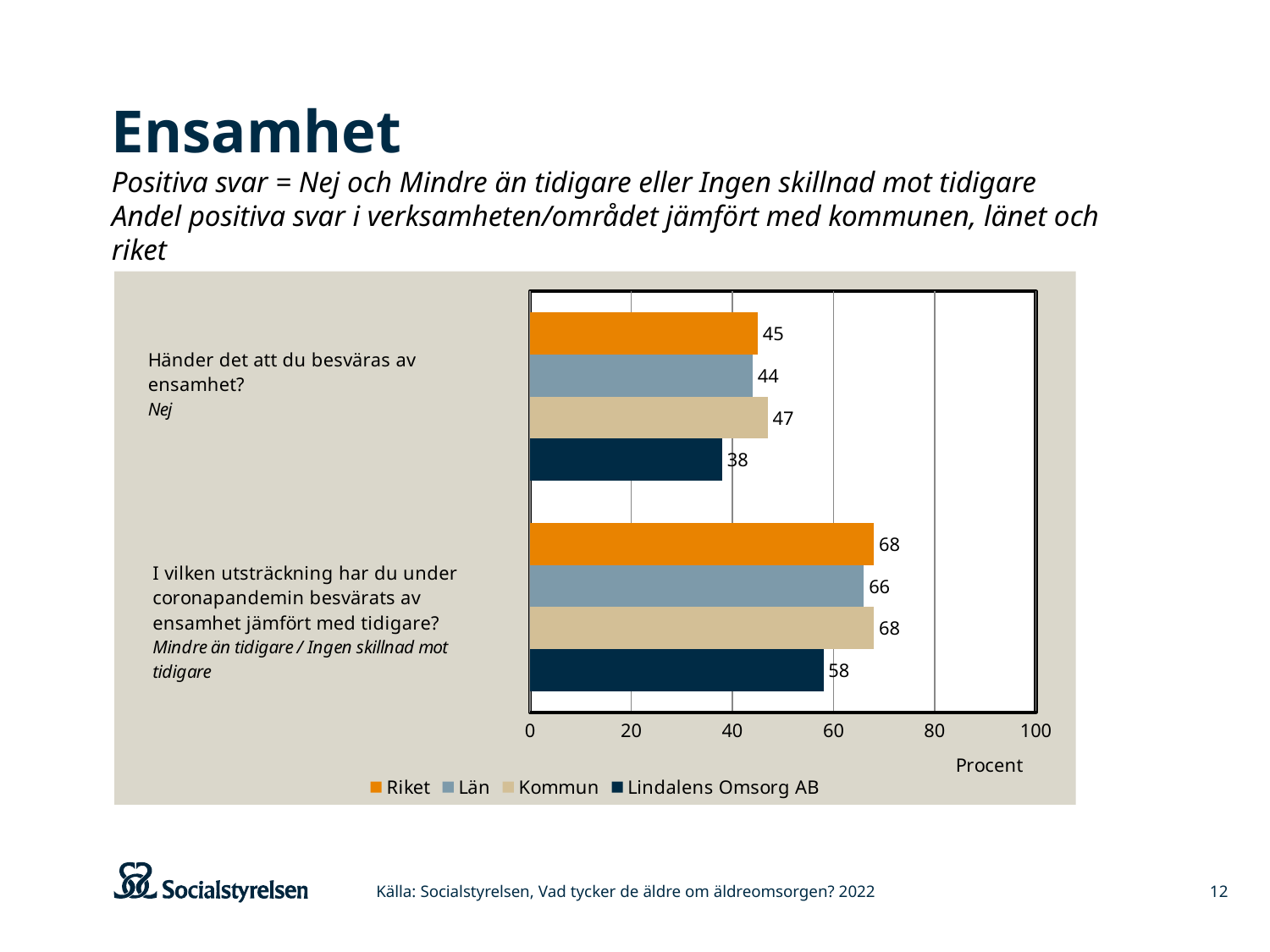
Which series has the lowest value for the question "Händer det att du besväras av ensamhet?"? Lindalens Omsorg AB Which is larger for the question "I vilken utsträckning har du under coronapandemin besvärats av ensamhet jämfört med tidigare?": Län or Lindalens Omsorg AB? Län What is the value for Lindalens Omsorg AB for the question "Händer det att du besväras av ensamhet?"? 38 What is the difference between Riket and Lindalens Omsorg AB for the question "I vilken utsträckning har du under coronapandemin besvärats av ensamhet jämfört med tidigare?"? 10 What is the value for Riket for the question "Händer det att du besväras av ensamhet?"? 45 What kind of chart is shown on the slide? Bar chart What is the value for Kommun for the question "I vilken utsträckning har du under coronapandemin besvärats av ensamhet jämfört med tidigare?"? 68 What is the value for Län for the question "I vilken utsträckning har du under coronapandemin besvärats av ensamhet jämfört med tidigare?"? 66 Which series has the highest value for the question "Händer det att du besväras av ensamhet?"? Kommun How many series does the legend list? 4 What is the label on the horizontal axis of the chart? Procent What is the difference between Kommun and Lindalens Omsorg AB for the question "Händer det att du besväras av ensamhet?"? 9